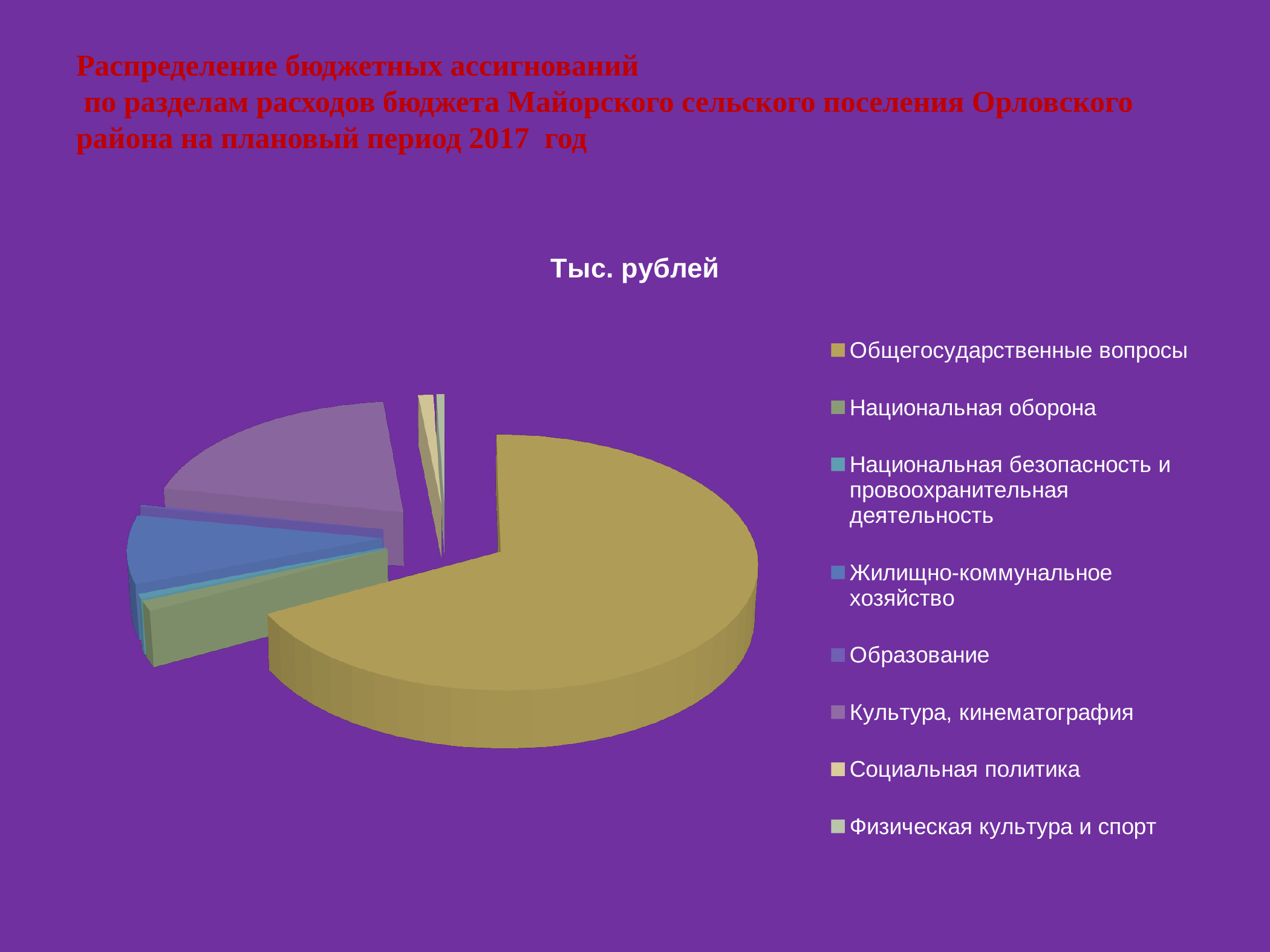
What kind of chart is shown on the slide? pie chart Which slice is larger: Культура, кинематография or Жилищно-коммунальное хозяйство? Культура, кинематография Which slice is larger: Общегосударственные вопросы or Культура, кинематография? Общегосударственные вопросы Which category has the largest slice in the pie chart? Общегосударственные вопросы What is the title shown above the pie chart? Тыс. рублей Which slice is larger: Культура, кинематография or Социальная политика? Культура, кинематография Which category is listed last in the legend of the pie chart? Физическая культура и спорт How many slices does the pie chart have? 8 How many categories does the legend of the pie chart list? 8